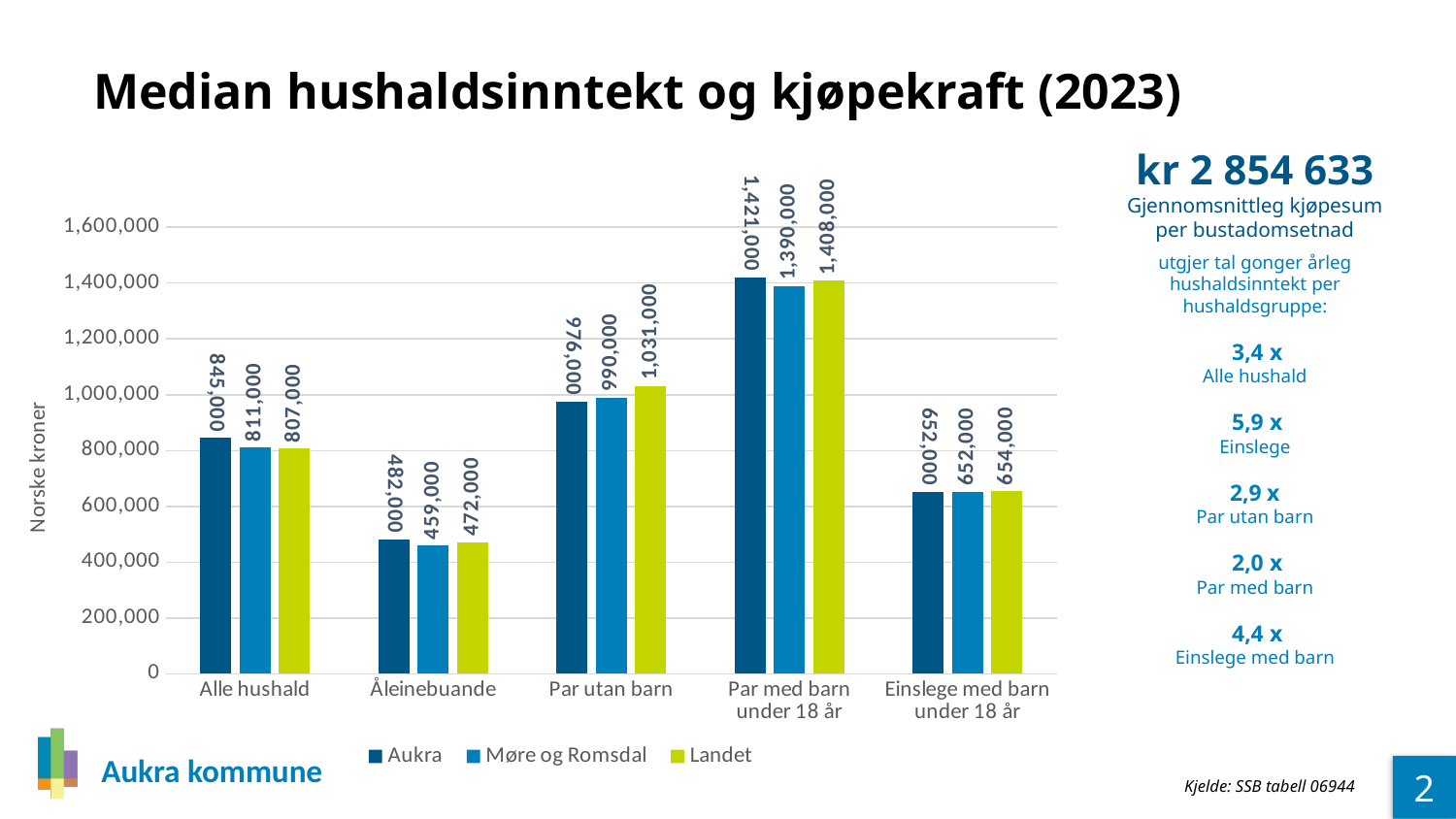
What is the value for Landet in the Par utan barn category? 1,031,000 What is the difference between the Aukra and Møre og Romsdal values in the Åleinebuande category? 23,000 In the Par utan barn category, which is larger: the value for Aukra or the value for Landet? Landet How many series does the legend list? 3 Is the value for Landet in the Einslege med barn under 18 år category greater or less than 800,000? less What kind of chart is shown on the slide? bar chart What is the label of the y axis? Norske kroner Which category has the highest value for Aukra? Par med barn under 18 år Which category has the lowest value for Landet? Åleinebuande What is the value for Aukra in the Alle hushald category? 845,000 What is the value for Møre og Romsdal in the Par med barn under 18 år category? 1,390,000 How many categories are shown on the x axis? 5